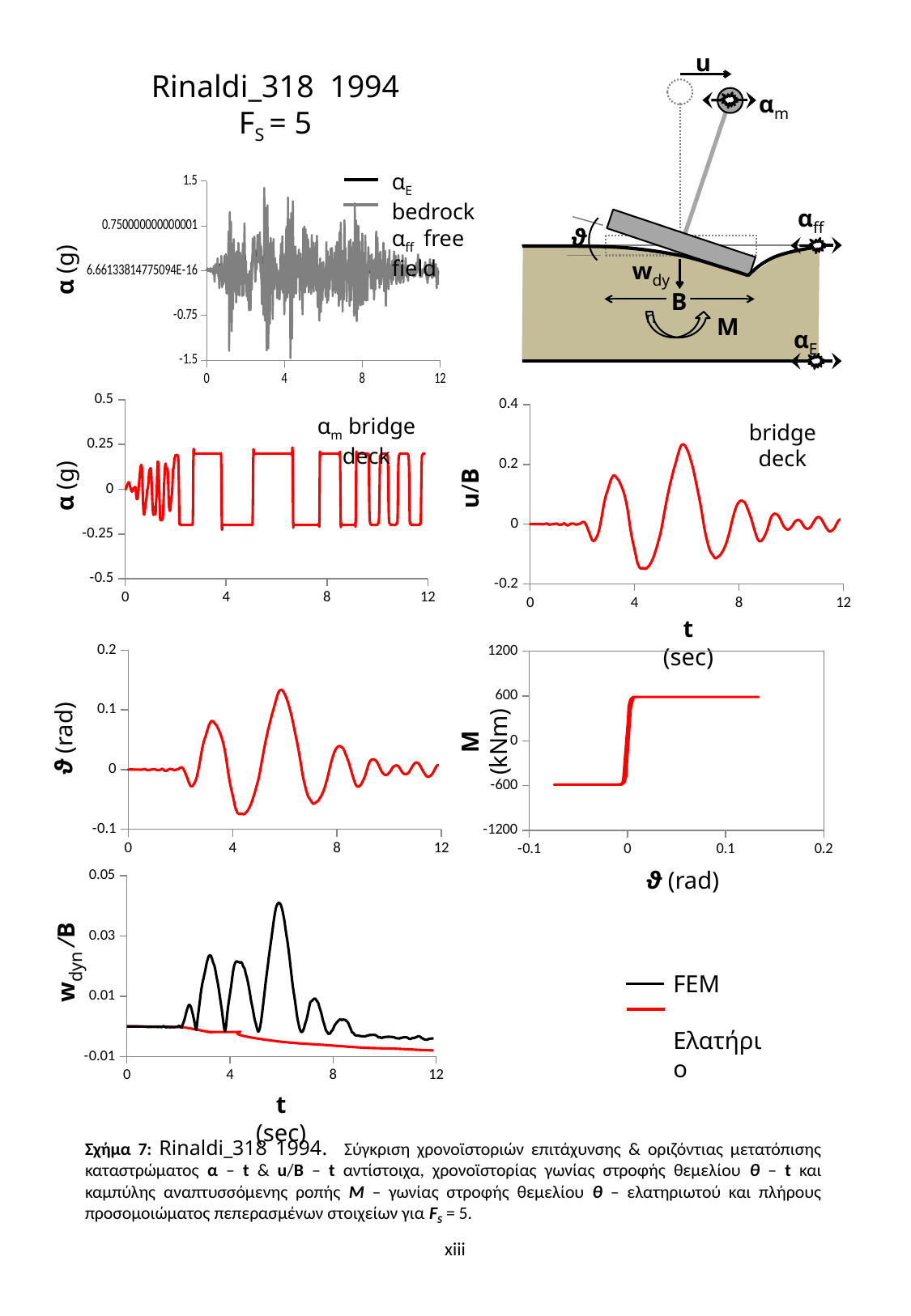
In the ϑ (rad) chart on the left, is the peak value of ϑ greater or less than 0.1? greater In the w_dyn/B chart at the bottom left, is the peak value of the FEM series greater or less than 0.03? greater What kind of chart is the u/B bridge deck chart on the right side of the slide? line chart In the top-left α (g) chart, how many series does the legend list? 2 In the w_dyn/B chart at the bottom left, which series has the larger peak value, FEM or Ελατήριο? FEM What is the x-axis label of the M (kNm) chart on the right side of the slide? ϑ (rad) In the u/B bridge deck chart, is the maximum value of u/B greater or less than 0.2? greater In the w_dyn/B chart at the bottom left, which series is drawn in black? FEM In the w_dyn/B chart at the bottom left, how many series does the legend list? 2